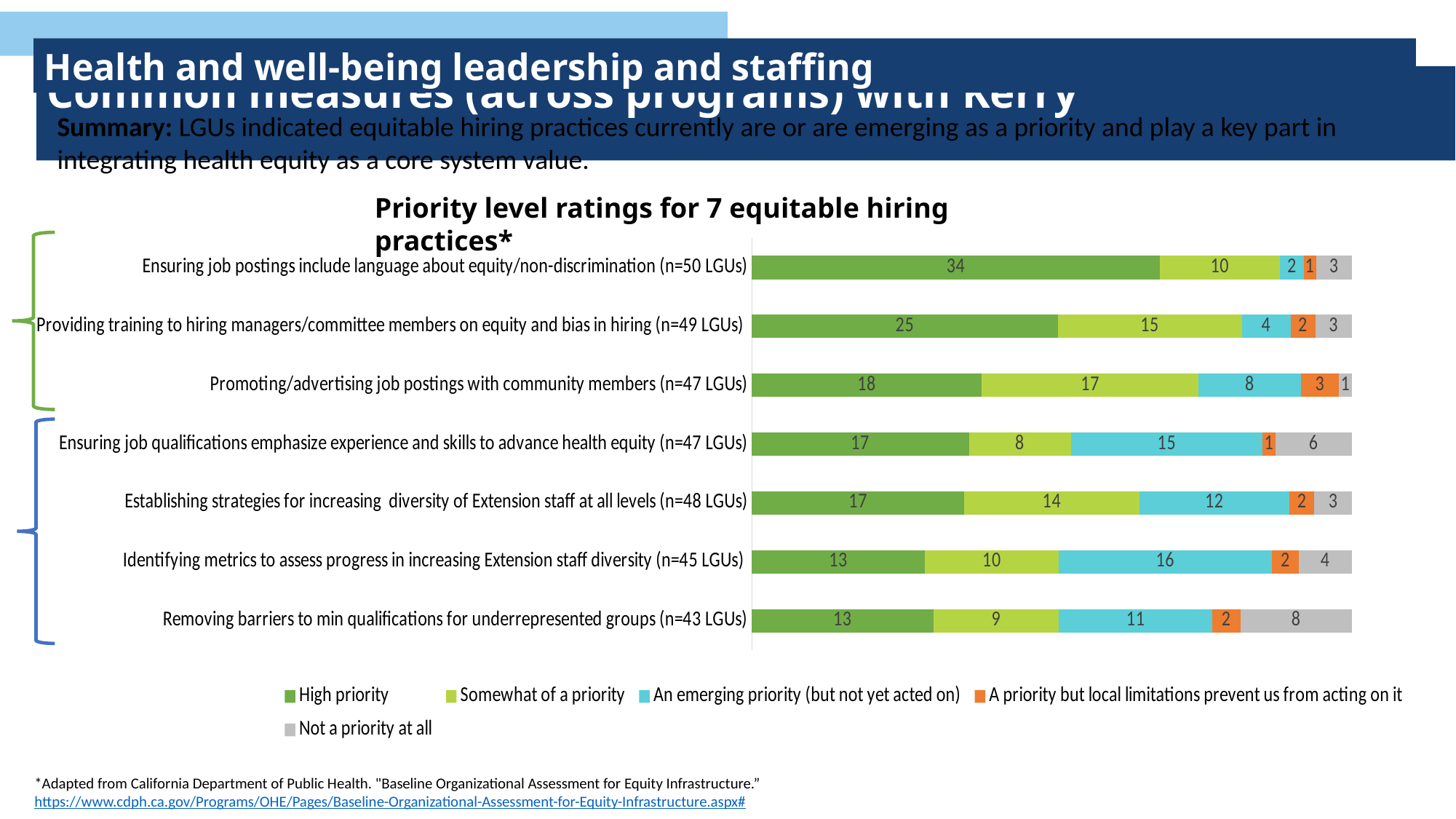
How many equitable hiring practices (categories) are plotted in the chart? 7 What is the 'Not a priority at all' value for 'Removing barriers to min qualifications for underrepresented groups'? 8 What kind of chart is shown on the slide? Stacked bar chart What is the total of all segments in the bar for 'Establishing strategies for increasing diversity of Extension staff at all levels'? 48 What is the title of the chart? Priority level ratings for 7 equitable hiring practices* Which practice has the lowest 'Not a priority at all' count? Promoting/advertising job postings with community members What is the 'An emerging priority (but not yet acted on)' value for 'Identifying metrics to assess progress in increasing Extension staff diversity'? 16 Which is larger for 'Ensuring job qualifications emphasize experience and skills to advance health equity': the 'Somewhat of a priority' count or the 'An emerging priority (but not yet acted on)' count? An emerging priority (but not yet acted on) What is the difference between the 'High priority' counts for 'Providing training to hiring managers/committee members on equity and bias in hiring' and 'Promoting/advertising job postings with community members'? 7 How many LGUs rated 'Ensuring job postings include language about equity/non-discrimination' as a high priority? 34 How many series does the legend list? 5 Which practice has the highest 'High priority' count? Ensuring job postings include language about equity/non-discrimination